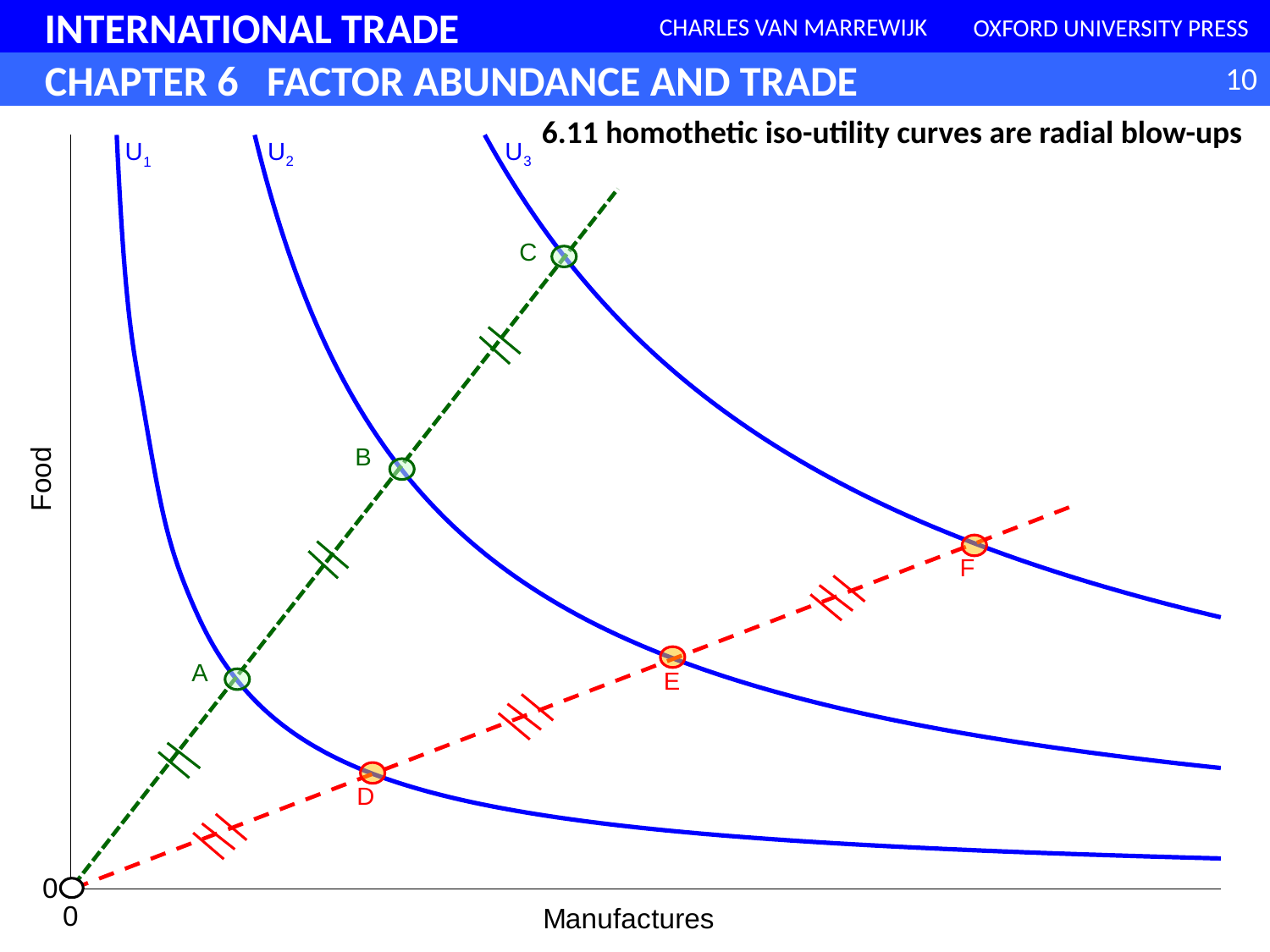
Do the blue iso-utility curves rise or fall as Manufactures increases along the x axis? fall Which of the labelled points A, B, C has the highest Food value? C How many labelled points (A to F) are marked on the curves in the chart? 6 Which point lies higher on the Food axis, point C or point A? C Which of the labelled points D, E, F has the lowest Food value? D Which point has more Manufactures, point E or point B? E Which point lies further along the Manufactures axis, point F or point D? F Which iso-utility curve do points C and F lie on? U3 What is the title of the chart on the slide? 6.11 homothetic iso-utility curves are radial blow-ups How many iso-utility curves (U curves) are drawn on the chart? 3 What label is on the vertical axis of the chart? Food